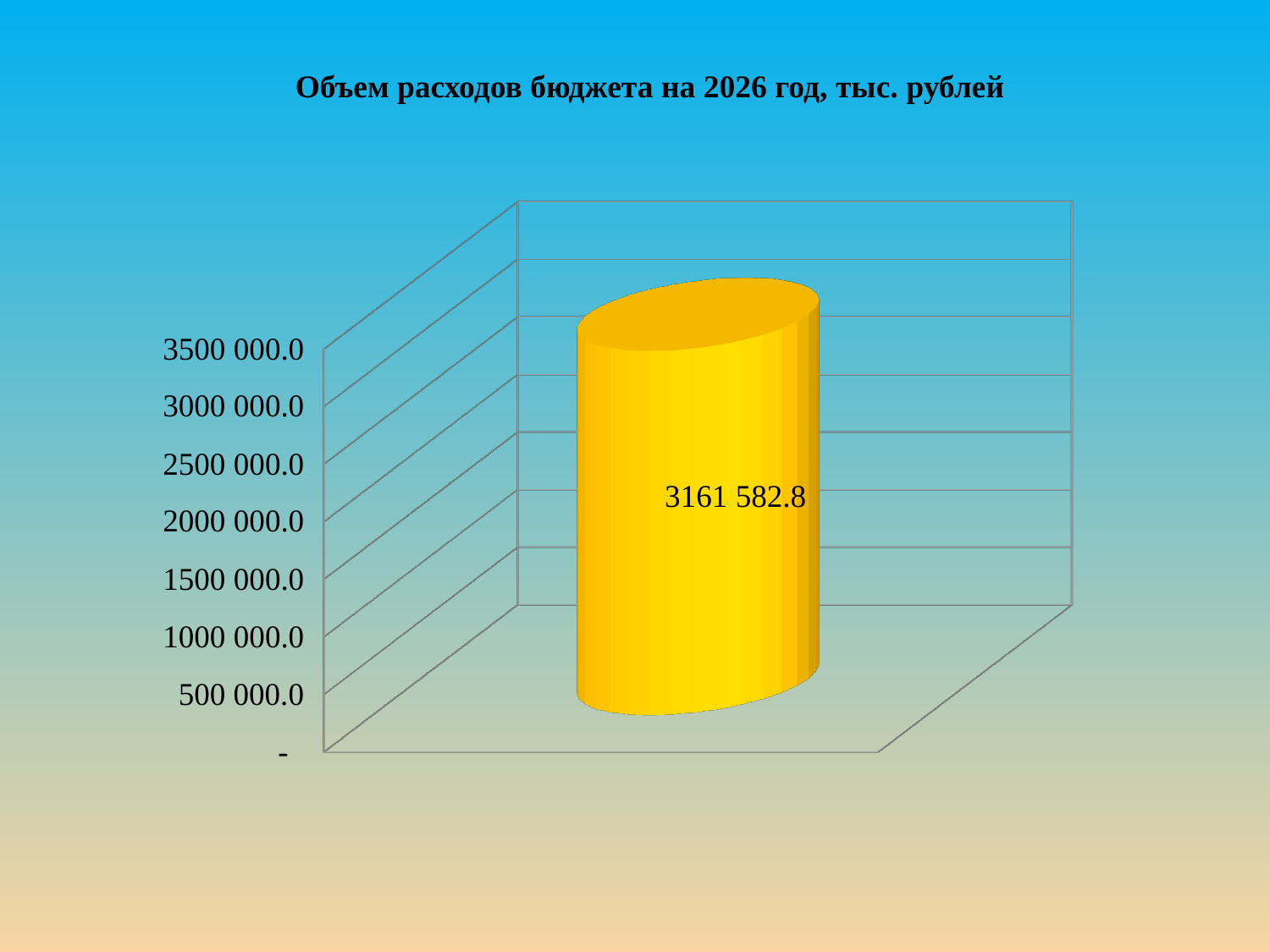
How many bars are plotted in the chart? 1 What value is shown on the bar in the chart? 3161 582.8 What is the budget expenditure volume for 2026 shown in the chart, in thousand rubles? 3161 582.8 What is the highest tick value shown on the vertical axis? 3500 000.0 Is the value of the bar greater or less than 3500 000.0? less Is the value of the bar greater or less than 3000 000.0? greater What kind of chart is shown on the slide? bar chart What is the title of the chart? Объем расходов бюджета на 2026 год, тыс. рублей